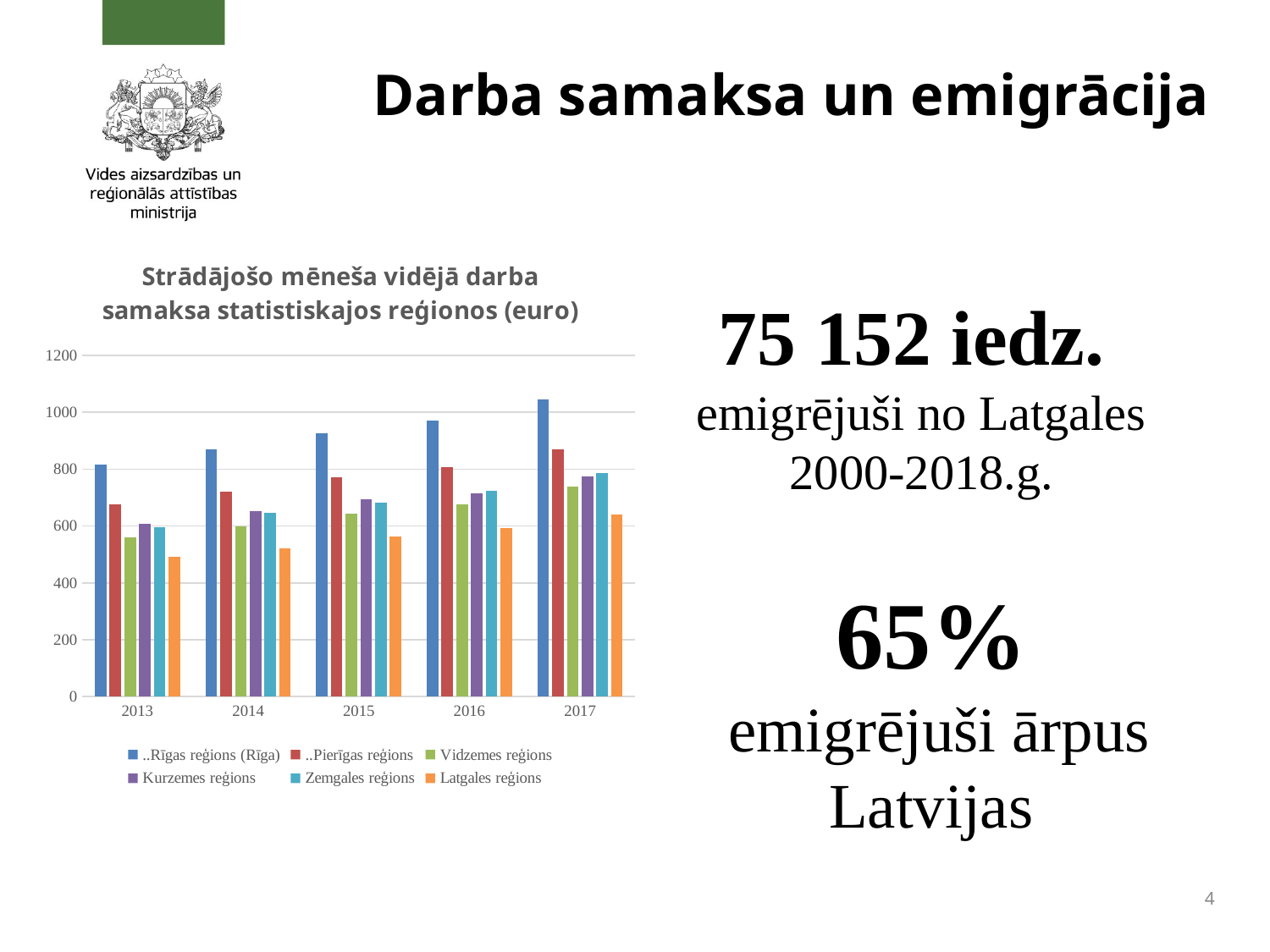
How many series does the chart's legend list? 6 How many years are shown on the x axis of the chart? 5 Is the value for Rīgas reģions (Rīga) in 2017 greater or less than 1000? greater Is the value for Latgales reģions in 2013 greater or less than 600? less What is the title of the chart? Strādājošo mēneša vidējā darba samaksa statistiskajos reģionos (euro) Which region has the highest average monthly wage in 2017? Rīgas reģions (Rīga) Which is larger in 2017: the value for Vidzemes reģions or for Latgales reģions? Vidzemes reģions Do the values for Rīgas reģions (Rīga) rise or fall from 2013 to 2017? rise Is the value for Pierīgas reģions in 2017 greater or less than 800? greater Which region has the lowest average monthly wage in 2013? Latgales reģions Which is larger in 2013: the value for Rīgas reģions (Rīga) or for Pierīgas reģions? Rīgas reģions (Rīga) What kind of chart is shown on the slide? bar chart